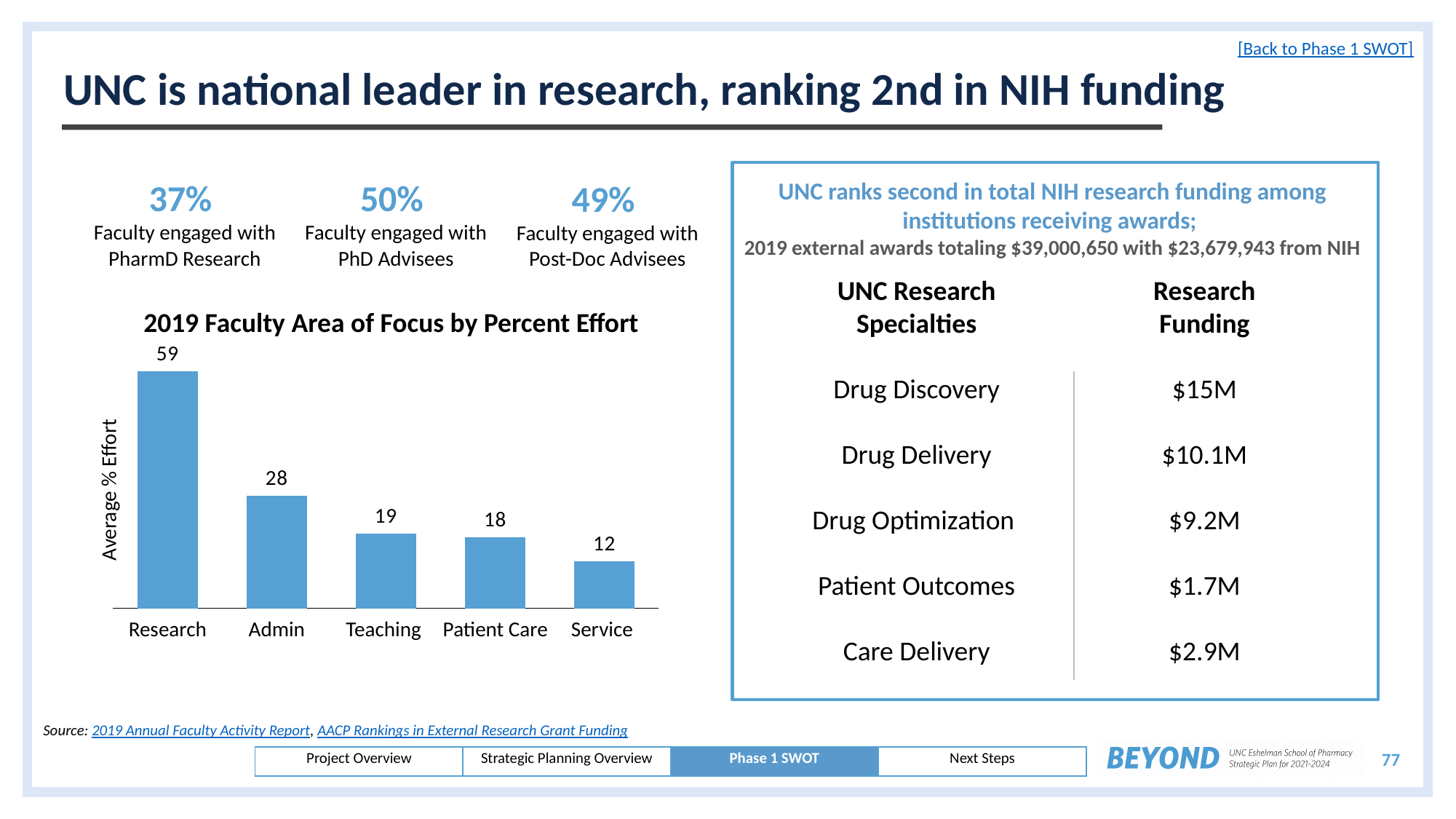
What type of chart is used to show 2019 Faculty Area of Focus by Percent Effort? Bar chart What is the average % effort for Research in the 2019 Faculty Area of Focus by Percent Effort chart? 59 What is the average % effort for Patient Care? 18 How many areas of focus are shown in the chart? 5 What is the label of the vertical axis of the chart? Average % Effort What is the difference in average % effort between Research and Admin? 31 Which area of focus has the highest average % effort? Research What is the average % effort for Service? 12 What is the average % effort for Teaching? 19 Which area of focus has the lowest average % effort? Service Which has a higher average % effort, Admin or Teaching? Admin What is the average % effort for Admin? 28